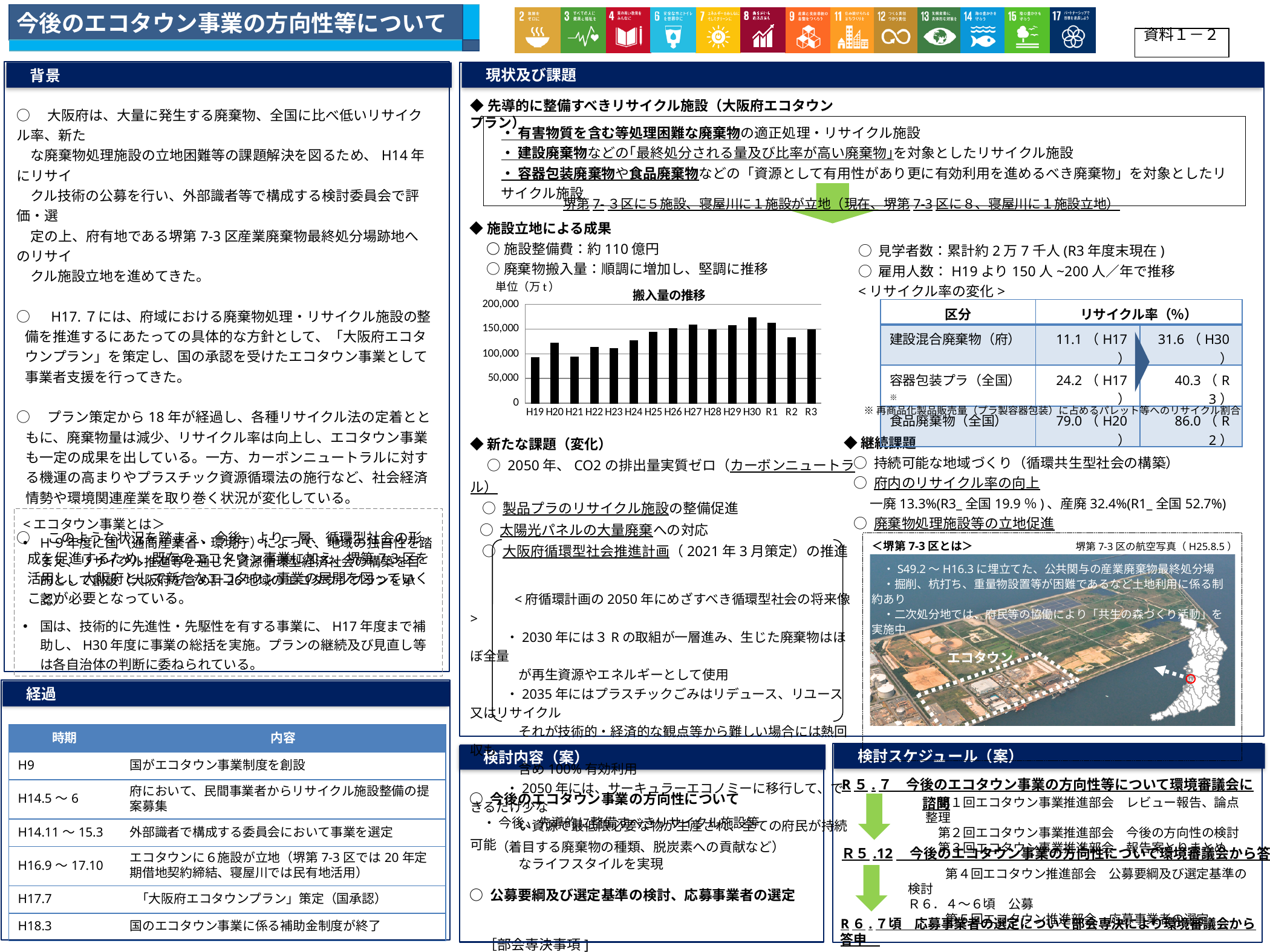
In the 搬入量の推移 chart, is the value for H19 greater or less than 100,000? less In the 搬入量の推移 chart, is the value for H20 greater or less than 100,000? greater Which year has the highest value in the 搬入量の推移 chart? H30 How many categories (years) are shown on the x axis of the 搬入量の推移 chart? 15 In the 搬入量の推移 chart, is the value for H30 greater or less than 150,000? greater In the 搬入量の推移 chart, which is larger, the value for H30 or the value for R2? H30 What kind of chart is the 搬入量の推移 chart? bar chart In the 搬入量の推移 chart, do the values generally rise or fall from H19 to H30? rise In the 搬入量の推移 chart, which is larger, the value for H19 or the value for H20? H20 What unit is indicated for the 搬入量の推移 chart? 万t